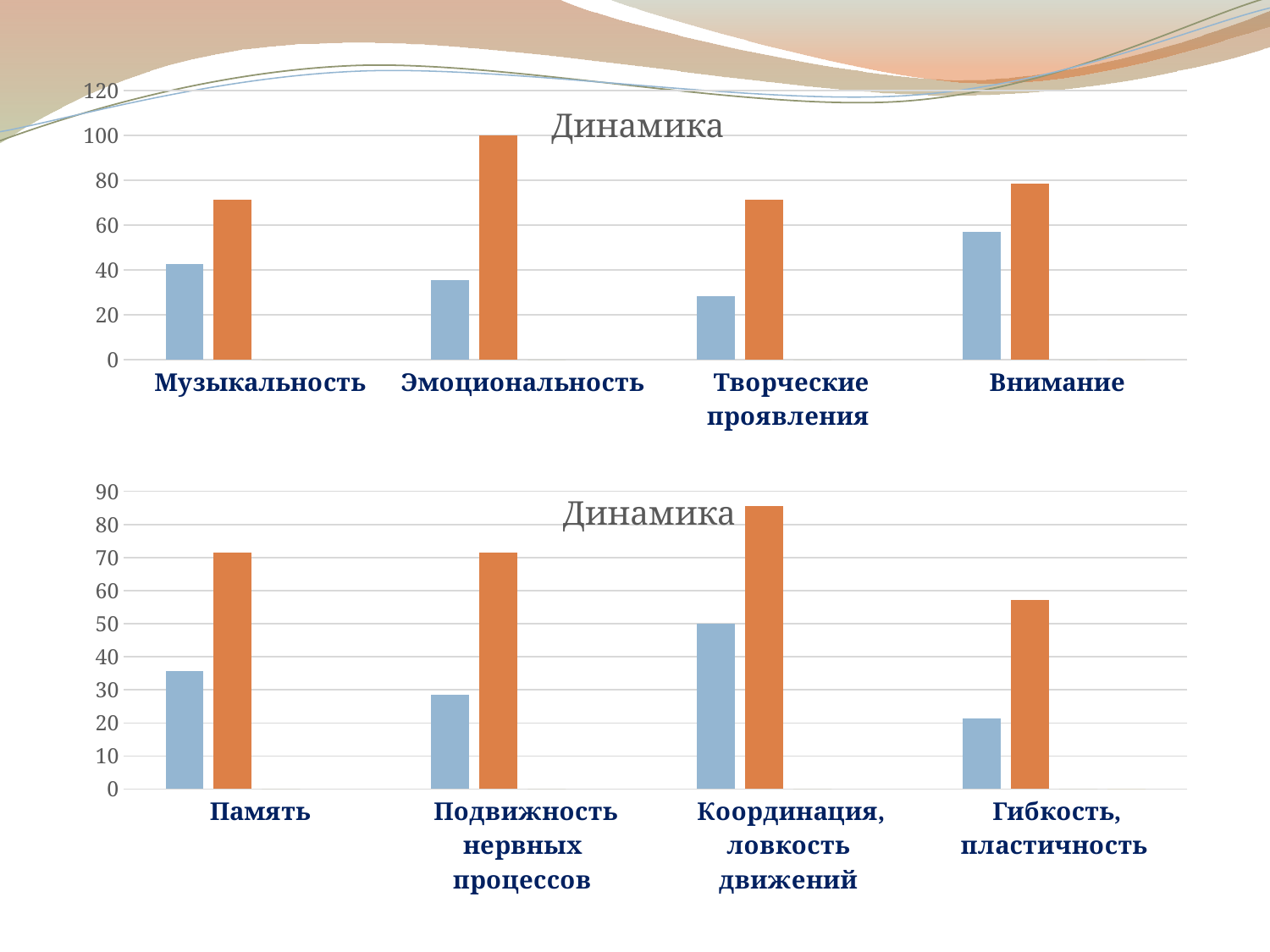
In the bottom chart, is the blue bar for Гибкость, пластичность greater or less than 30? less In the bottom chart, what is the value of the blue bar for Координация, ловкость движений? 50 In the bottom chart, which is larger for Память: the blue bar or the orange bar? the orange bar How many categories are shown on the x axis of the top chart? 4 In the top chart, which category has the lowest blue bar? Творческие проявления In the top chart, what is the value of the orange bar for Эмоциональность? 100 In the top chart, which category has the highest orange bar? Эмоциональность In the bottom chart, which category has the lowest blue bar? Гибкость, пластичность How many categories are shown on the x axis of the bottom chart? 4 What type of chart is the top chart titled "Динамика"? bar chart In the top chart, is the orange bar for Внимание greater or less than 60? greater In the bottom chart, which category has the highest orange bar? Координация, ловкость движений